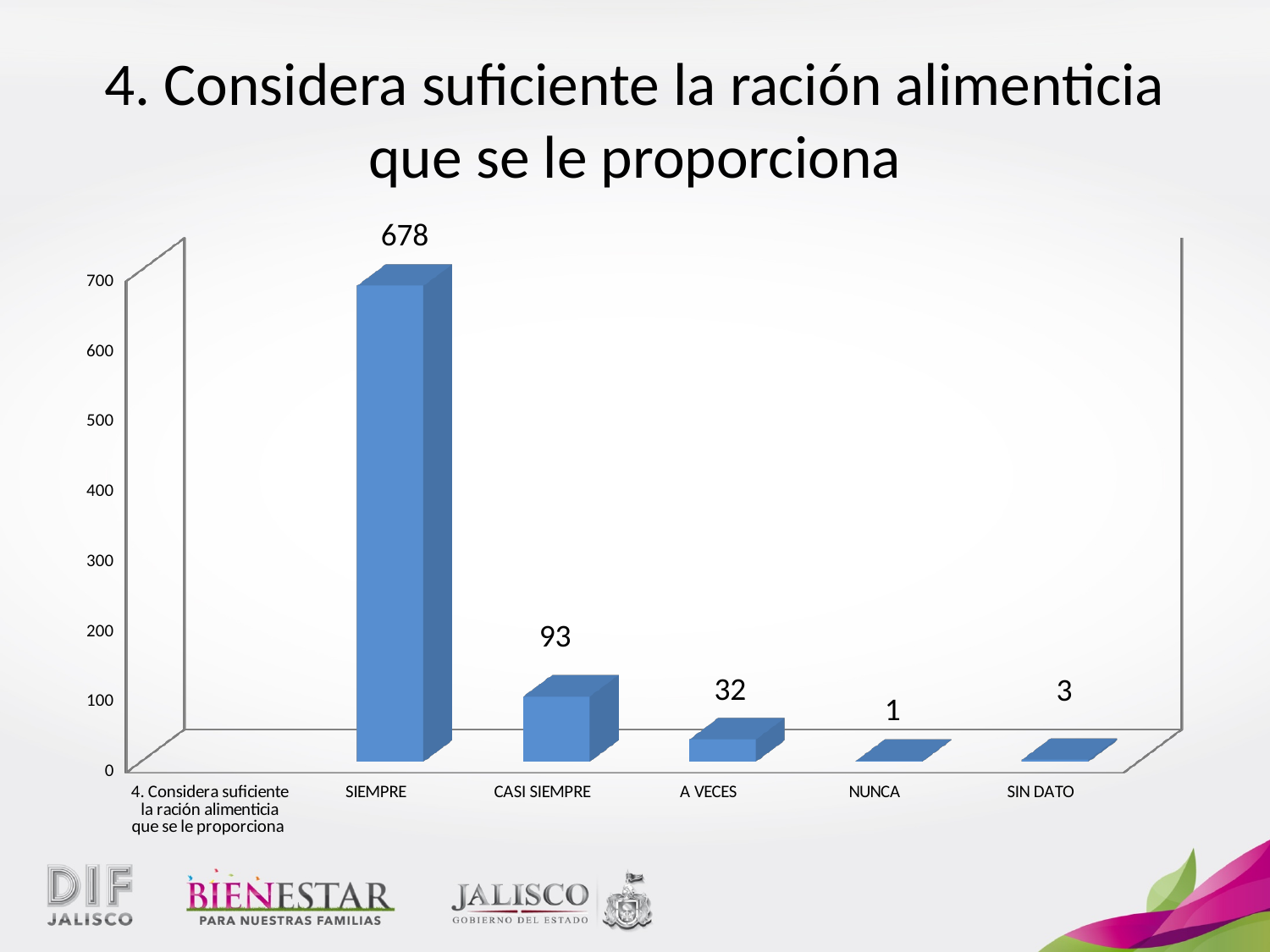
How many bars are plotted in the chart? 5 What is the value for A VECES? 32 Is the value for CASI SIEMPRE greater or less than 100? less What is the value for SIN DATO? 3 What is the value for CASI SIEMPRE? 93 What is the value for NUNCA? 1 What is the difference between the values for SIEMPRE and CASI SIEMPRE? 585 What kind of chart is shown on the slide? bar chart Which category has the lowest value? NUNCA What is the value for SIEMPRE? 678 Which is larger, the value for A VECES or the value for SIN DATO? A VECES Which category has the highest value? SIEMPRE